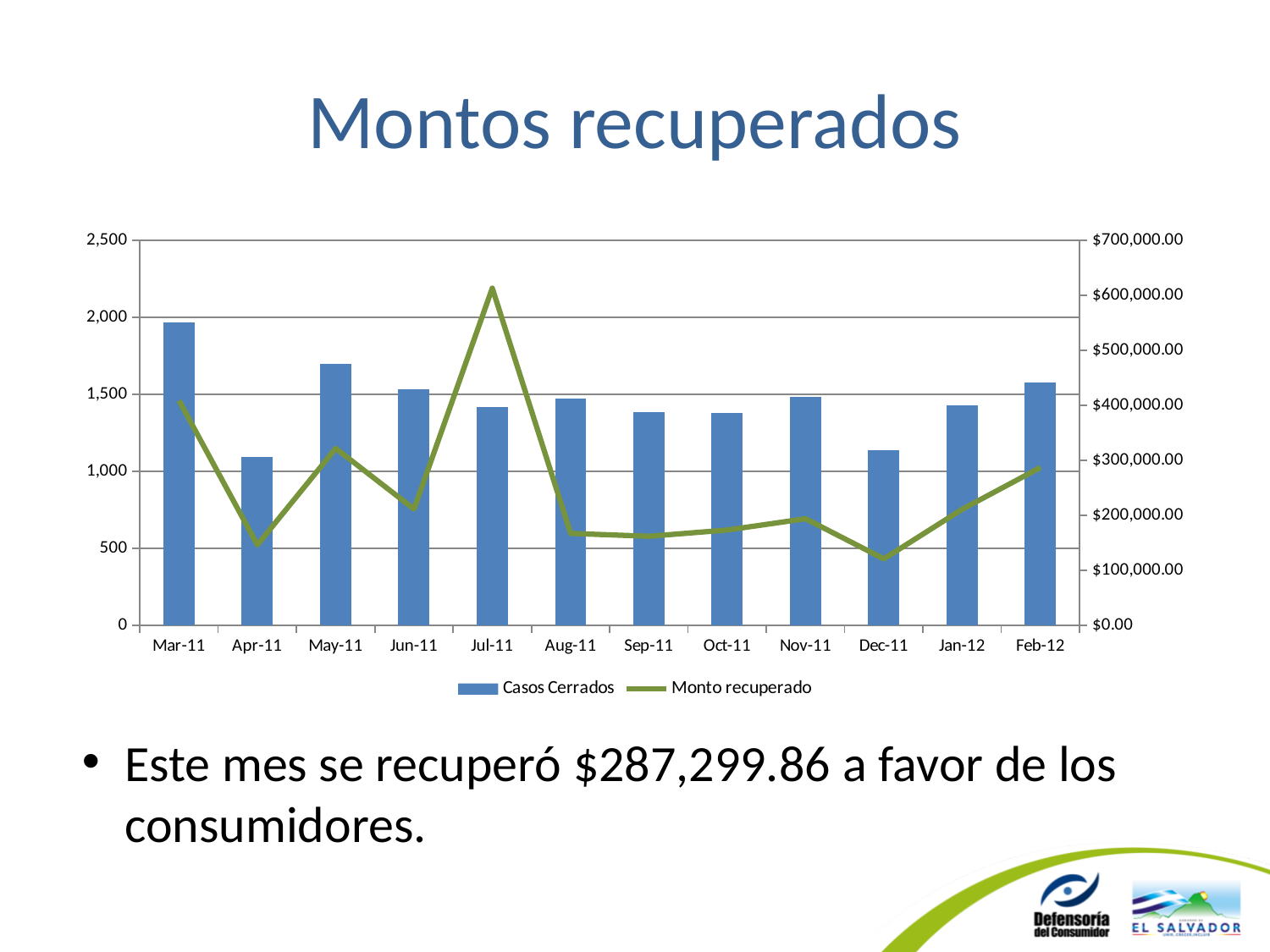
Which month has the highest number of Casos Cerrados? Mar-11 How many months are shown on the x axis? 12 Which month has more Casos Cerrados, May-11 or Jun-11? May-11 Which month has the lowest Monto recuperado? Dec-11 Which series is drawn as a line in the chart? Monto recuperado Is the number of Casos Cerrados for Mar-11 greater or less than 1,500? greater Is the number of Casos Cerrados for Apr-11 greater or less than 1,500? less What kind of chart is shown on the slide? A combined bar and line chart How many series does the legend list? 2 What is the title of the chart? Montos recuperados Is the Monto recuperado for Jul-11 greater or less than $500,000.00? greater Which month has the highest Monto recuperado? Jul-11